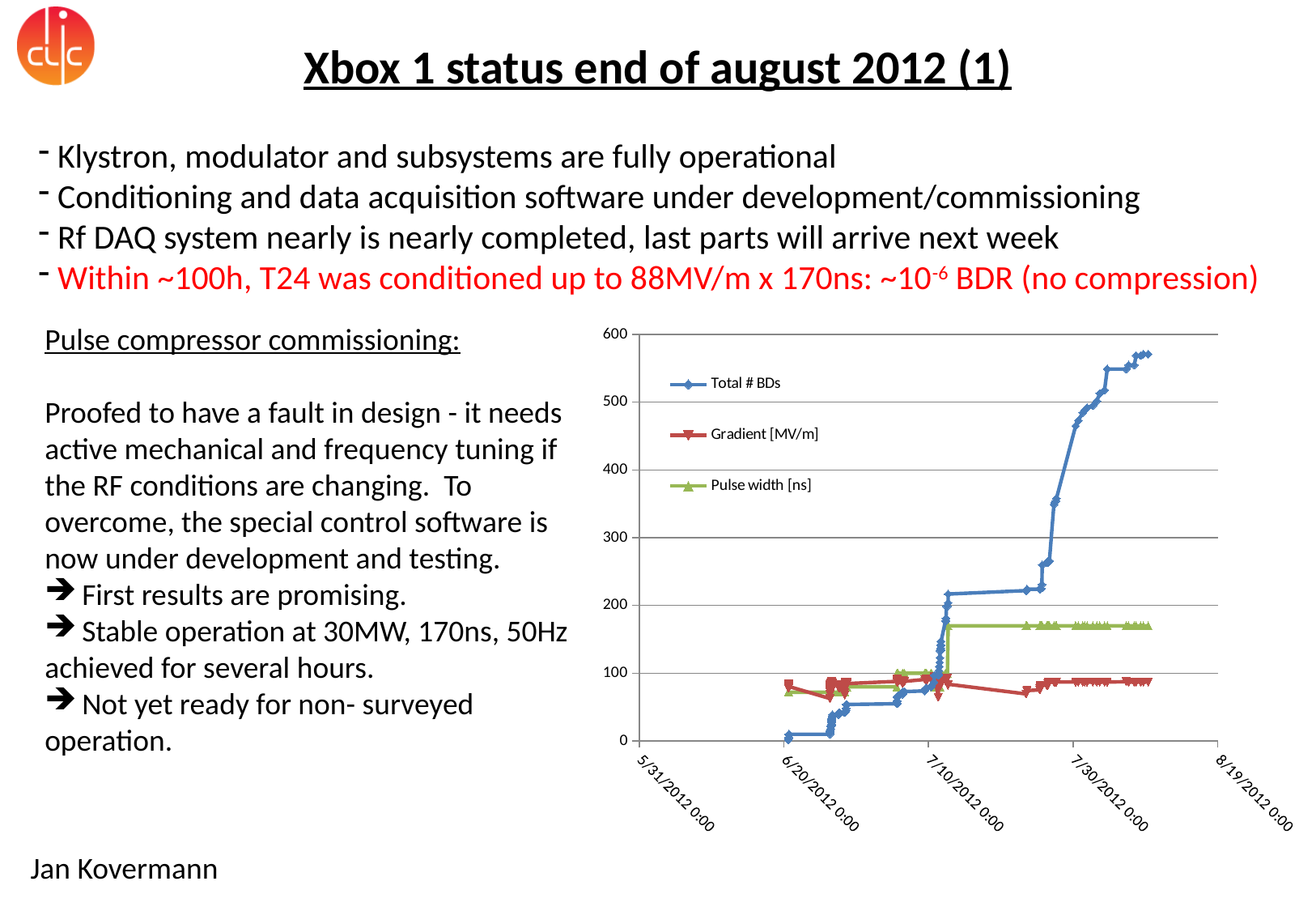
Is the value of the Total # BDs series near 6/20/2012 greater or less than 100? less How many date labels are shown on the chart's horizontal axis? 5 At the end of the plotted period, which is larger: the Pulse width [ns] value or the Gradient [MV/m] value? Pulse width [ns] What kind of chart is shown on the slide? line chart Which series reaches the highest value on the chart? Total # BDs Which series are listed in the chart legend? Total # BDs, Gradient [MV/m], Pulse width [ns] Does the Total # BDs series rise or fall over time along the x axis? rise What is the maximum value shown on the chart's vertical axis? 600 Is the final value of the Total # BDs series greater or less than 500? greater Is the value of the Gradient [MV/m] series at the end of the plotted period greater or less than 100? less How many series does the chart legend list? 3